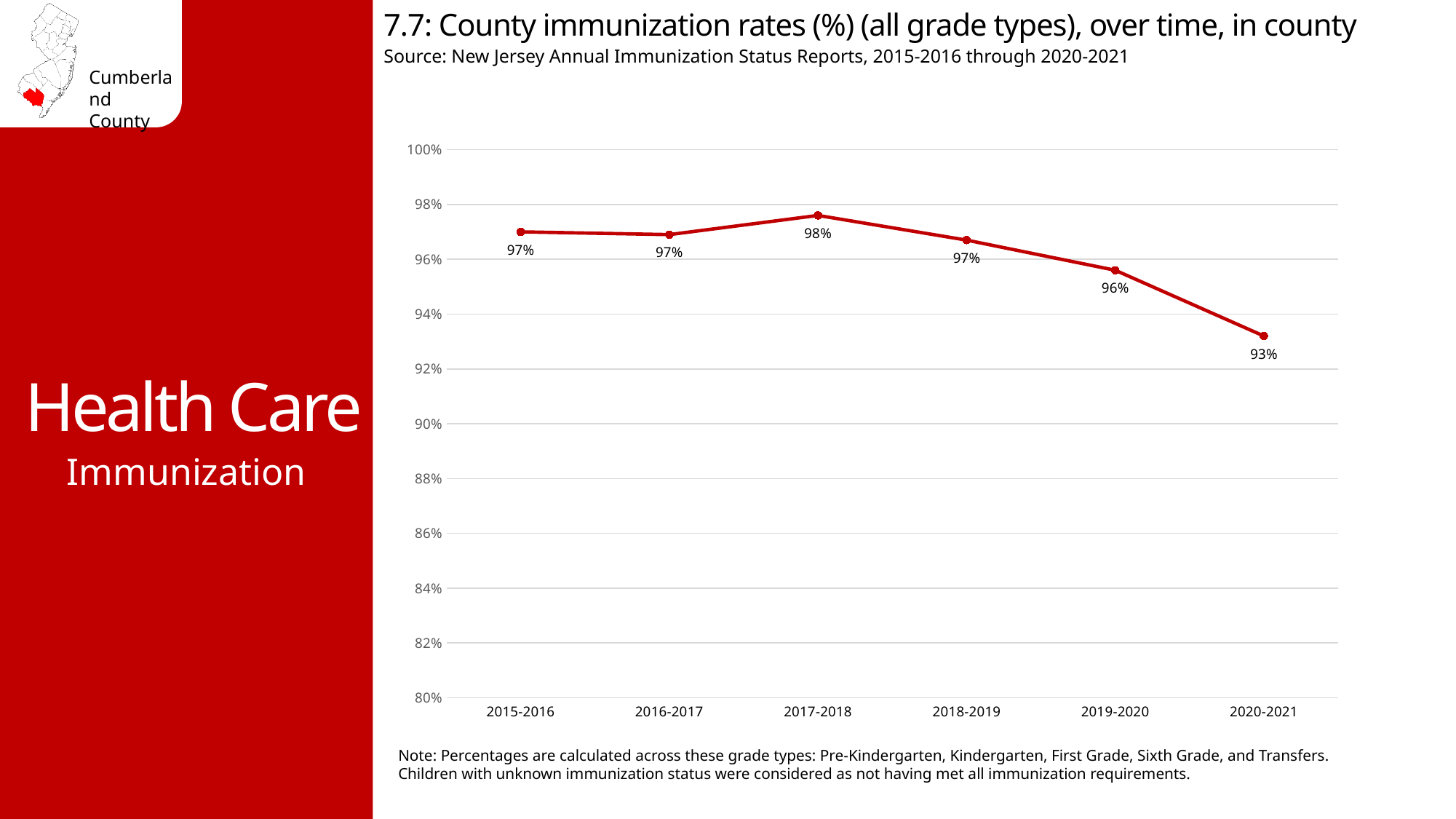
What was the county immunization rate in 2017-2018? 98% Is the immunization rate for 2020-2021 greater or less than 94%? less Which school year had the highest immunization rate? 2017-2018 Which school year had the lowest immunization rate? 2020-2021 What was the county immunization rate in 2020-2021? 93% What was the county immunization rate in 2015-2016? 97% Which year had a higher immunization rate, 2019-2020 or 2020-2021? 2019-2020 What type of chart is shown on the slide? line chart What is the overall trend in immunization rates from 2017-2018 to 2020-2021? falling What was the county immunization rate in 2019-2020? 96% What is the difference in immunization rate between 2017-2018 and 2020-2021, using the printed labels? 5% How many school years are plotted on the chart? 6